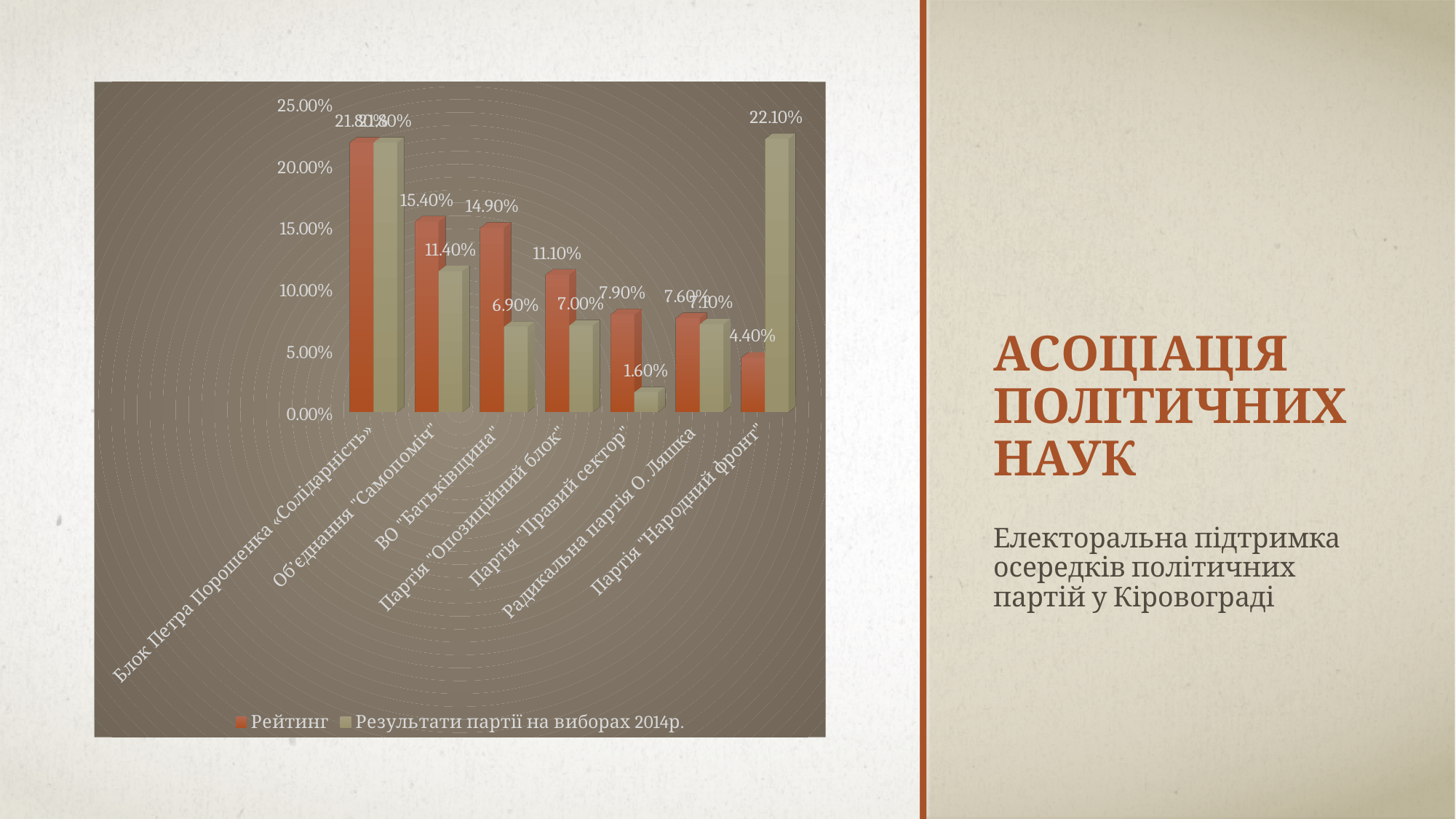
What is the Рейтинг value for Об'єднання "Самопоміч"? 15.40% How many series does the legend list? 2 How many parties are shown on the x axis? 7 Which party has the highest Результати партії на виборах 2014р. value? Партія "Народний фронт" What is the Результати партії на виборах 2014р. value for Партія "Правий сектор"? 1.60% What is the difference between the Рейтинг and the Результати партії на виборах 2014р. values for ВО "Батьківщина"? 8.00% What is the Рейтинг value for Партія "Народний фронт"? 4.40% What kind of chart is shown on the slide? Bar chart Which party has the lowest Рейтинг value? Партія "Народний фронт" What is the Результати партії на виборах 2014р. value for ВО "Батьківщина"? 6.90% Which is larger for Партія "Опозиційний блок": the Рейтинг value or the Результати партії на виборах 2014р. value? Рейтинг What is the difference between the Рейтинг and the Результати партії на виборах 2014р. values for Партія "Народний фронт"? 17.70%